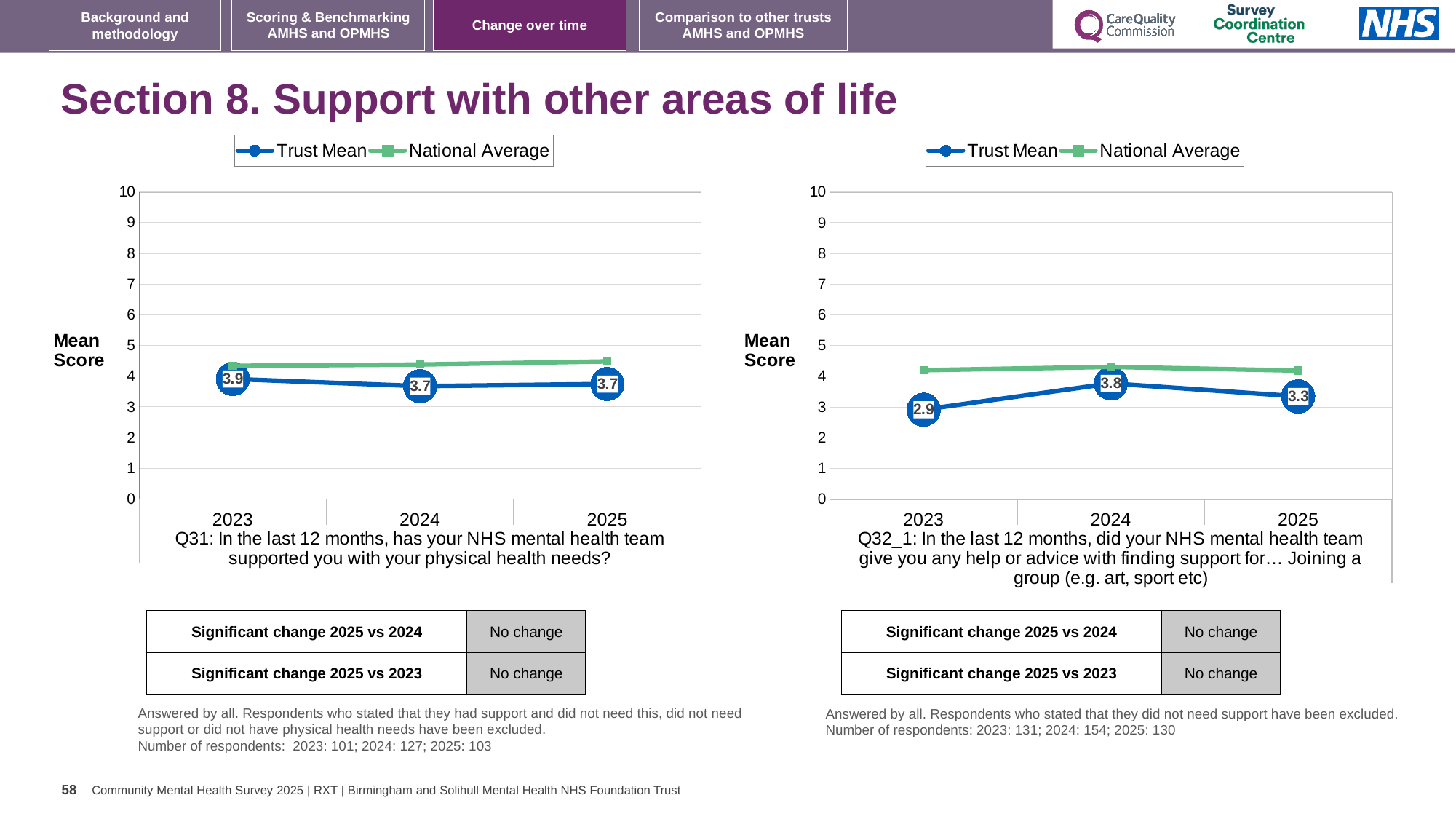
On the right chart (Q32_1), is the National Average for 2023 greater or less than 5? less On the left chart (Q31), is the National Average for 2025 greater or less than 4? greater On the right chart (Q32_1), which year has the highest Trust Mean? 2024 On the left chart (Q31), is the Trust Mean for 2023 larger or smaller than the Trust Mean for 2024? larger How many series does the legend of the left chart (Q31) list? 2 On the right chart (Q32_1), which year has the lowest Trust Mean? 2023 On the right chart (Q32_1), what is the Trust Mean for 2023? 2.9 On the left chart (Q31), what is the Trust Mean for 2023? 3.9 What type of chart is the right chart (Q32_1)? Line chart On the right chart (Q32_1), what is the Trust Mean for 2024? 3.8 On the right chart (Q32_1), what is the difference between the Trust Mean for 2024 and 2023? 0.9 On the left chart (Q31), what is the Trust Mean for 2025? 3.7